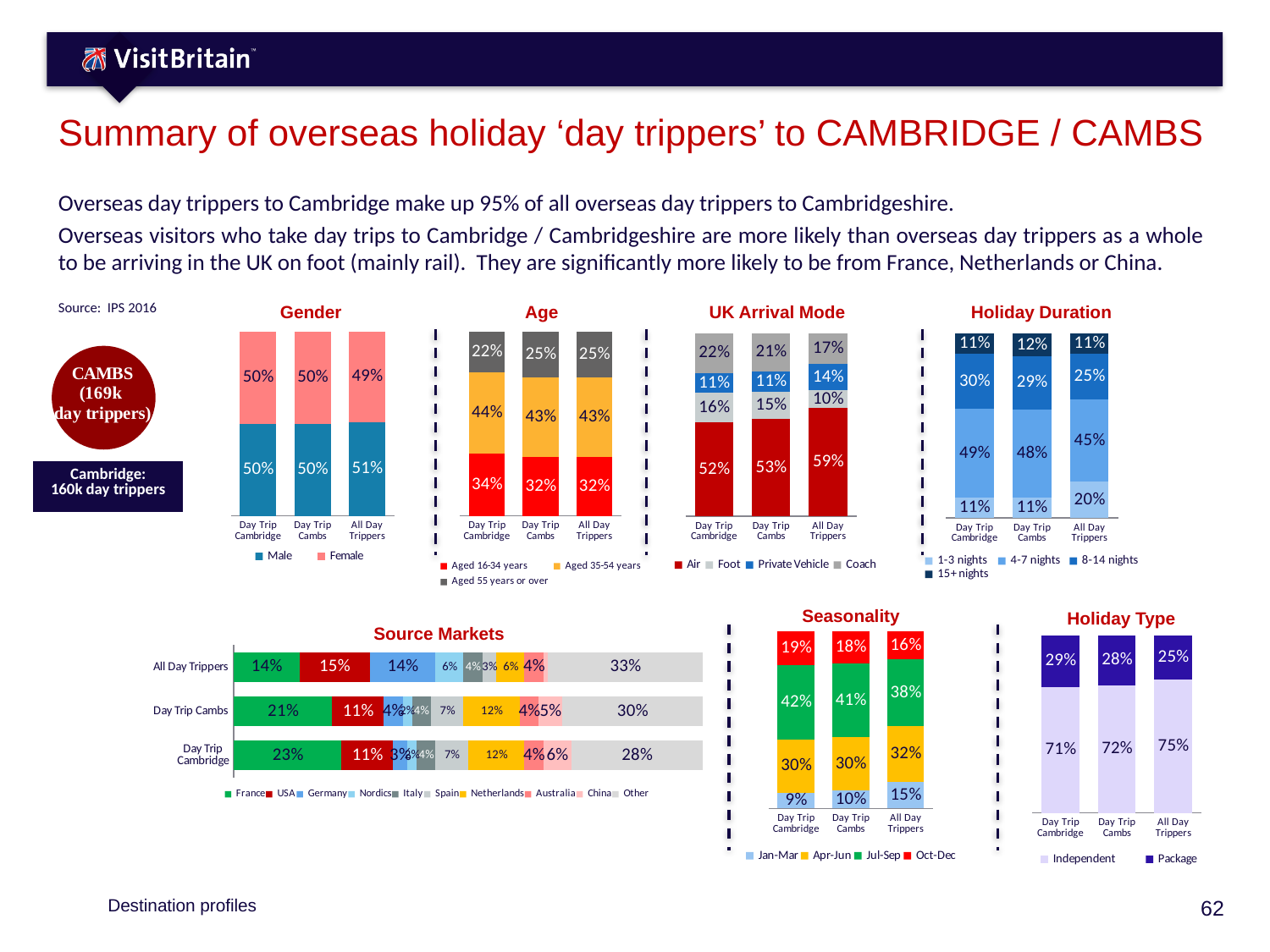
In the Seasonality chart, which category has the lowest Jan-Mar share? Day Trip Cambridge In the Holiday Type chart, what percentage of All Day Trippers are Independent? 75% In the UK Arrival Mode chart, what percentage of Day Trip Cambridge visitors arrive by Foot? 16% In the Gender chart, what percentage of All Day Trippers are Male? 51% In the Holiday Duration chart, what percentage of Day Trip Cambs visitors stay 4-7 nights? 48% In the Source Markets chart, is the Other share larger for All Day Trippers or for Day Trip Cambridge? All Day Trippers In the UK Arrival Mode chart, what is the difference between the Air share for All Day Trippers and for Day Trip Cambridge? 7% In the Seasonality chart, what percentage of Day Trip Cambridge visits occur in Jul-Sep? 42% In the Age chart, what share of Day Trip Cambridge visitors are Aged 35-54 years? 44% In the Holiday Duration chart, which category has the largest 1-3 nights share? All Day Trippers How many series does the legend of the Seasonality chart list? 4 In the Source Markets chart, what is the France share for Day Trip Cambridge? 23%